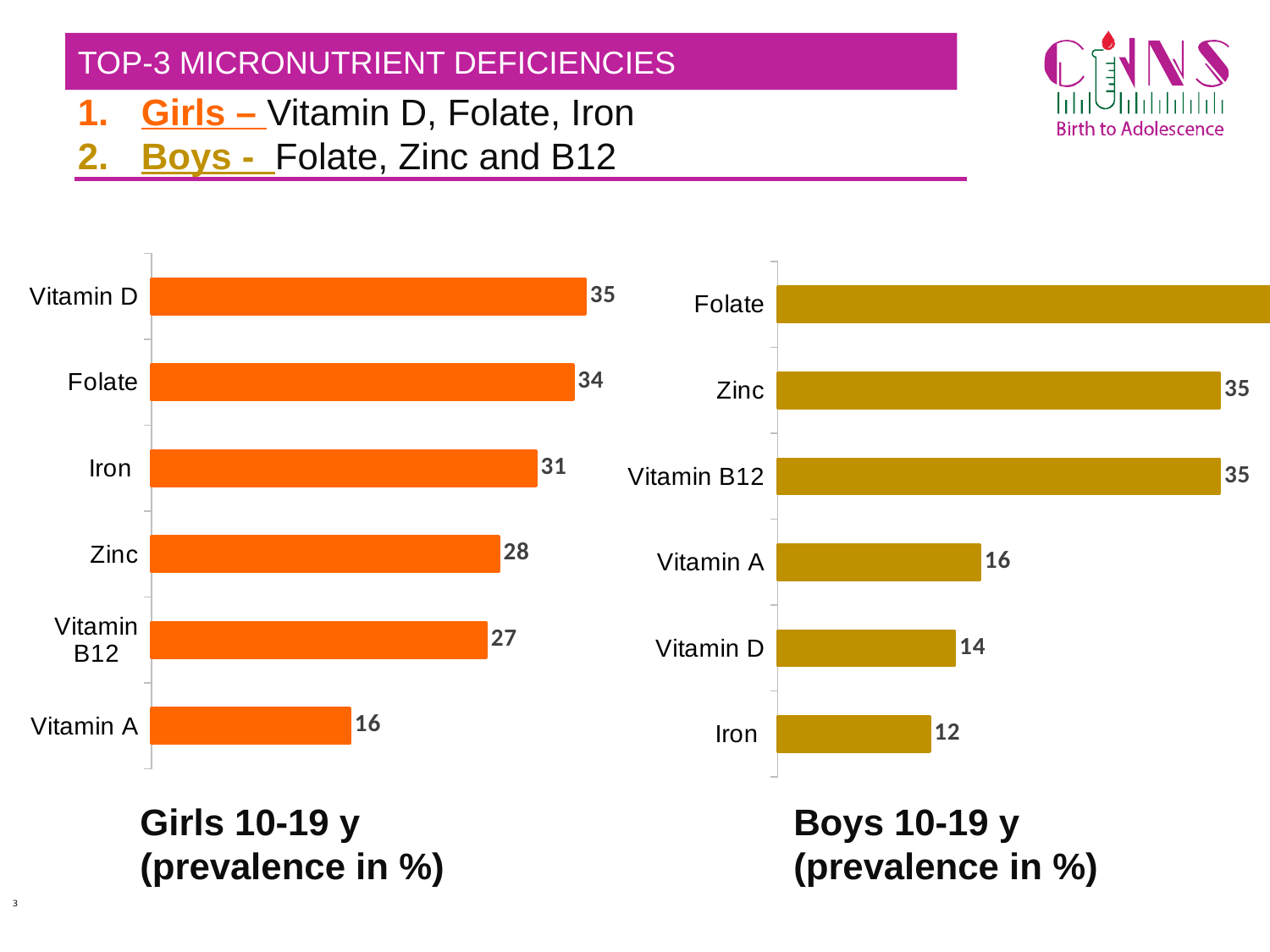
In the Girls 10-19 y chart, what is the difference between the values for Vitamin D and Vitamin A? 19 In the Boys 10-19 y chart, what is the value for Vitamin A? 16 In the Girls 10-19 y chart, which is larger, the value for Zinc or the value for Vitamin B12? Zinc In the Boys 10-19 y chart, what is the difference between the values for Zinc and Vitamin D? 21 In the Boys 10-19 y chart, what is the value for Iron? 12 What type of chart is the Boys 10-19 y chart? Bar chart In the Girls 10-19 y chart, which micronutrient has the lowest prevalence of deficiency? Vitamin A How many micronutrients are shown in the Girls 10-19 y chart? 6 In the Boys 10-19 y chart, which micronutrient has the highest prevalence of deficiency? Folate In the Girls 10-19 y chart, what is the prevalence of Vitamin D deficiency? 35 In the Girls 10-19 y chart, what is the value for Iron? 31 In the Boys 10-19 y chart, which micronutrient has the lowest prevalence of deficiency? Iron